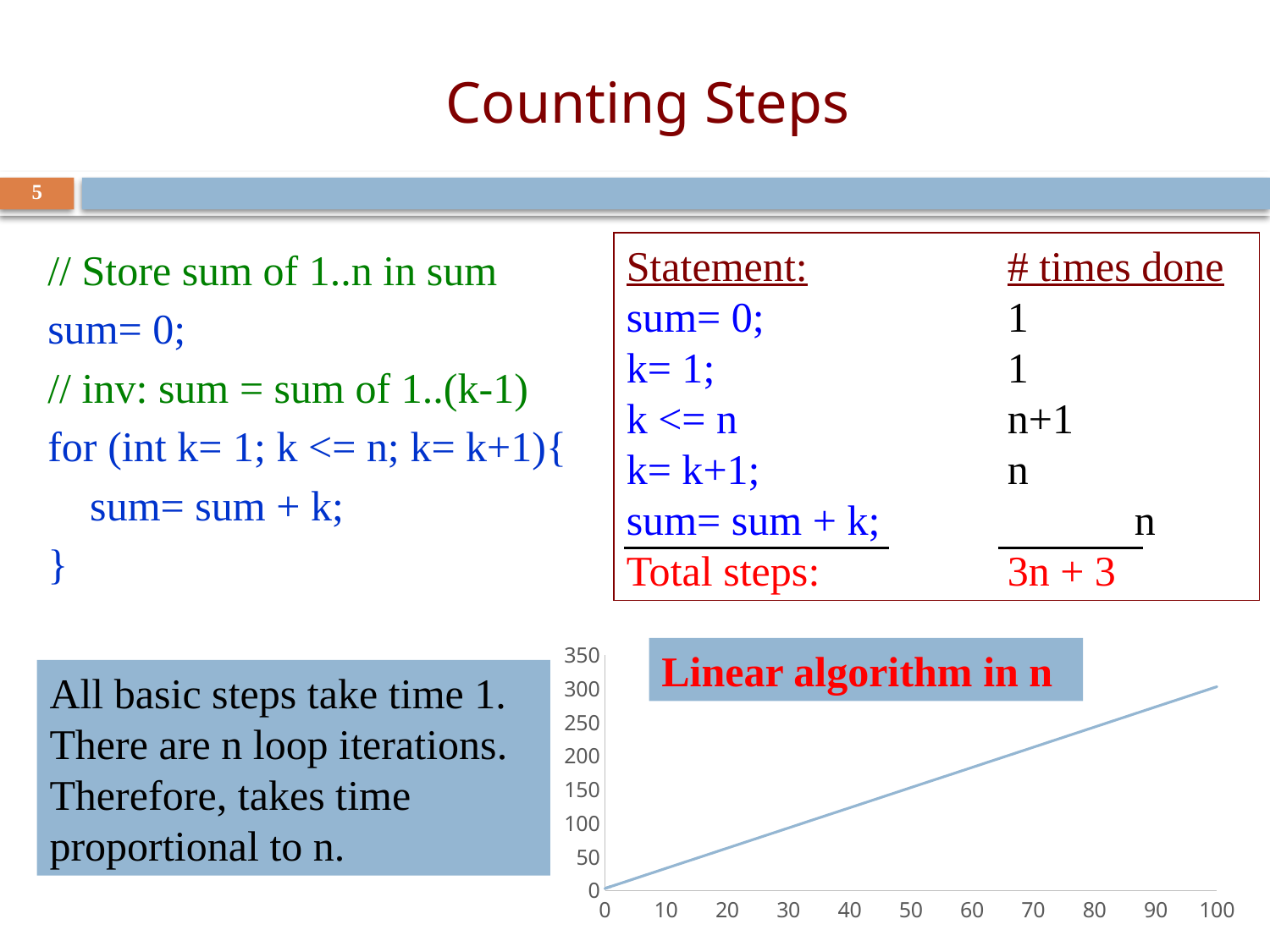
In the chart at the bottom right, is the value at x = 50 greater or less than 200? less How many tick labels are shown on the x axis of the chart at the bottom right? 11 In the chart at the bottom right, do the values rise or fall as the x axis increases from 0 to 100? rise In the chart at the bottom right, is the value at x = 100 greater or less than 250? greater In the chart at the bottom right, is the value at x = 20 greater or less than 100? less What is the highest value shown on the x axis of the chart at the bottom right? 100 What is the highest value shown on the y axis of the chart at the bottom right? 350 What kind of chart is shown at the bottom right of the slide? line chart How many lines are plotted in the chart at the bottom right? 1